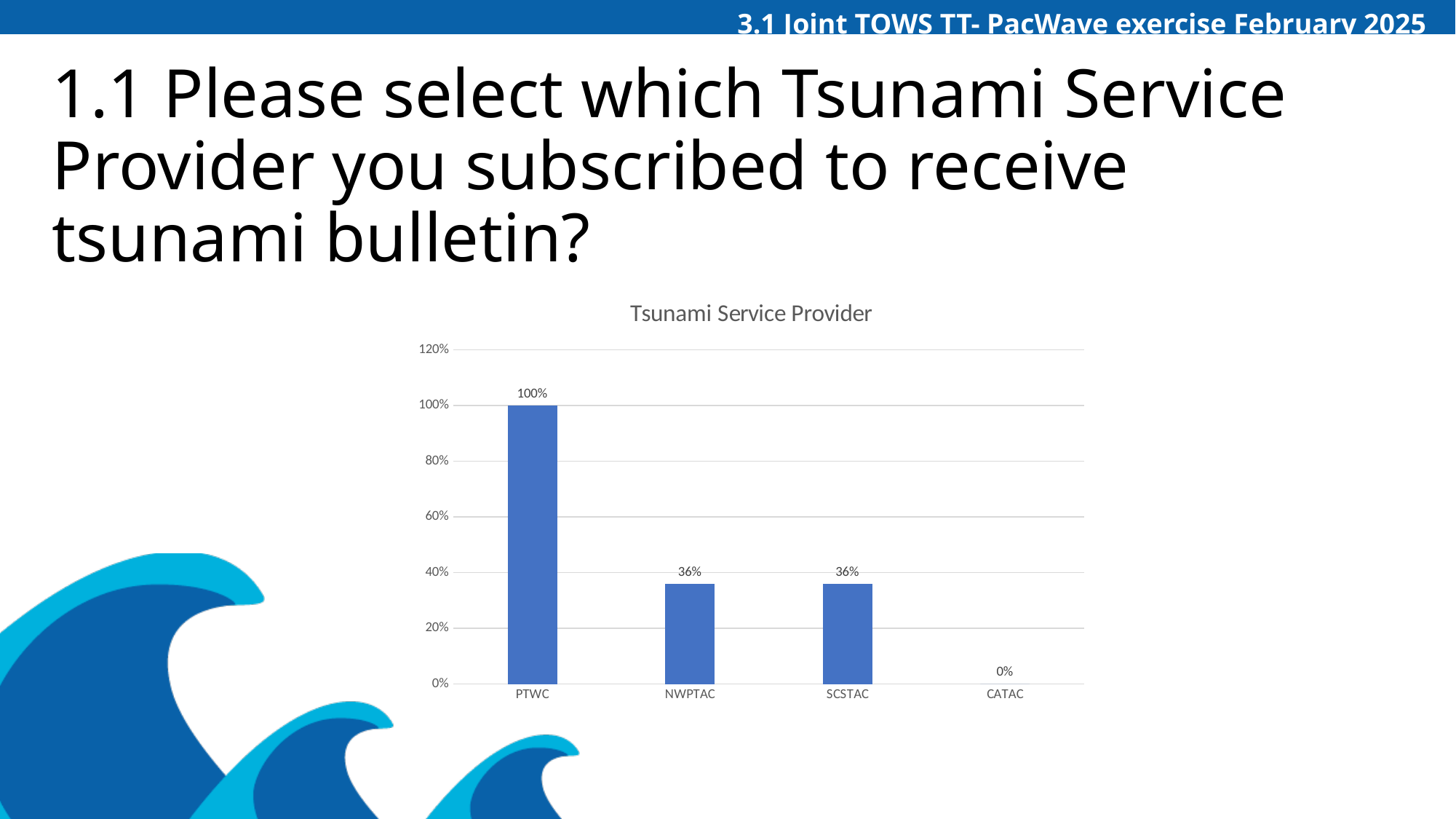
What is the value for NWPTAC? 36% What is the title of the chart? Tsunami Service Provider What is the value for CATAC? 0% Which is larger, the value for PTWC or the value for SCSTAC? PTWC Is the value for NWPTAC greater or less than 40%? less What kind of chart is shown on the slide? bar chart What is the value for SCSTAC? 36% Which Tsunami Service Provider has the highest value? PTWC Which Tsunami Service Provider has the lowest value? CATAC How many Tsunami Service Providers are shown on the x axis? 4 What is the value for PTWC? 100% What is the difference between the values for PTWC and NWPTAC? 64%